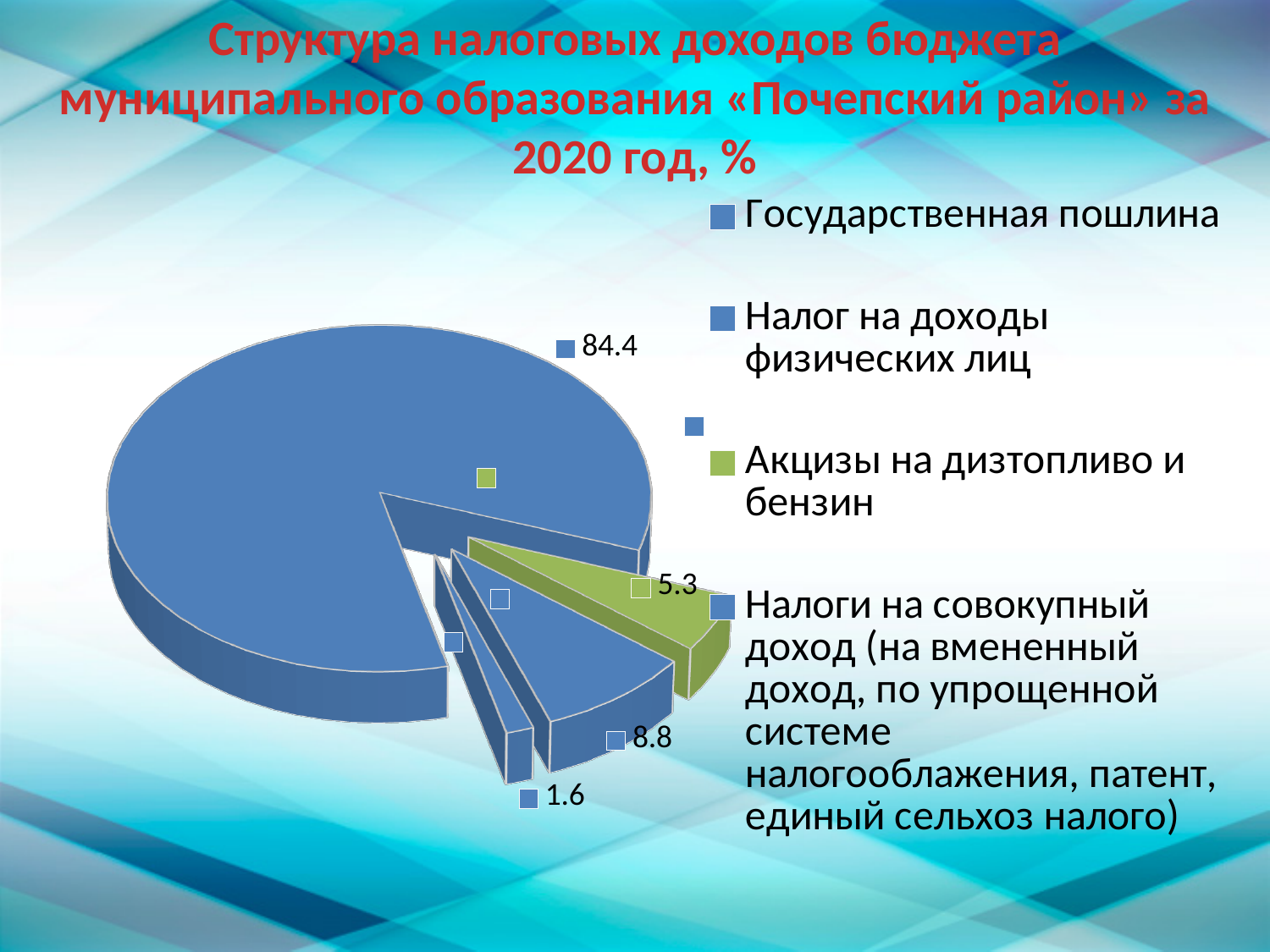
What value is shown for the green slice, Акцизы на дизтопливо и бензин? 5.3 Which is larger: the slice labelled 8.8 or the slice for Акцизы на дизтопливо и бензин? the slice labelled 8.8 How many slices with data labels does the pie chart have? 4 Which legend entry is shown in green? Акцизы на дизтопливо и бензин What is the difference between the largest slice (84.4) and the slice labelled 8.8? 75.6 What is the largest value labelled on the pie chart? 84.4 What is the smallest value labelled on the pie chart? 1.6 What is the difference between the slice labelled 8.8 and the slice for Акцизы на дизтопливо и бензин (5.3)? 3.5 What is the title of the chart? Структура налоговых доходов бюджета муниципального образования «Почепский район» за 2020 год, % What kind of chart is shown on the slide? pie chart